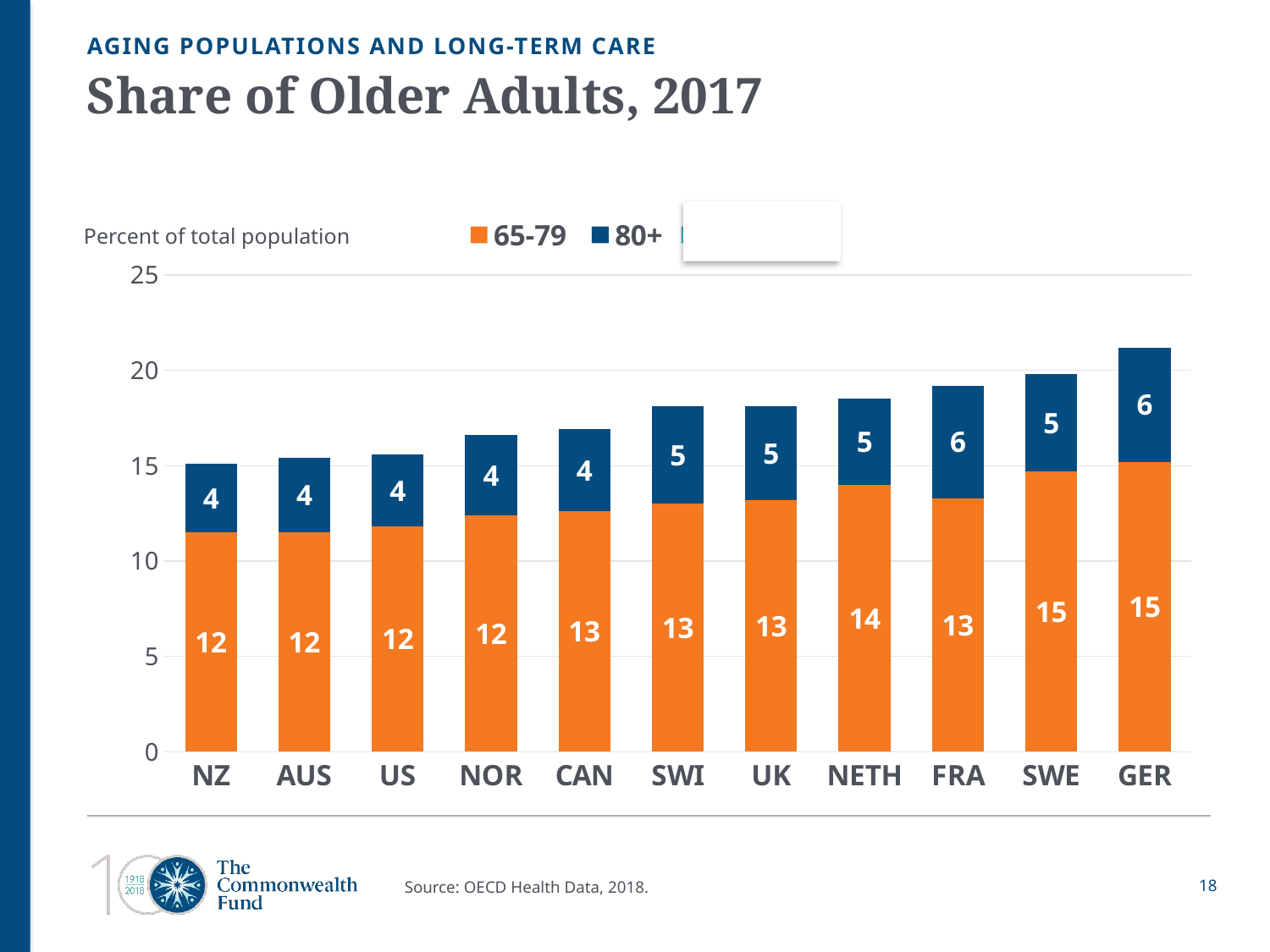
What is the total of the stacked bar for GER? 21 What is the difference between the 65-79 values for GER and NZ? 3 What is the value for the 80+ series for SWE? 5 Which country has the tallest stacked bar overall? GER How many countries are shown on the x axis? 11 How many series does the legend list? 2 Which has the larger 80+ value, FRA or UK? FRA What is the total of the stacked bar for NZ? 16 What kind of chart is shown on the slide? Stacked bar chart What is the value for the 80+ series for NZ? 4 What is the value for the 65-79 series for CAN? 13 What is the value for the 65-79 series for NETH? 14